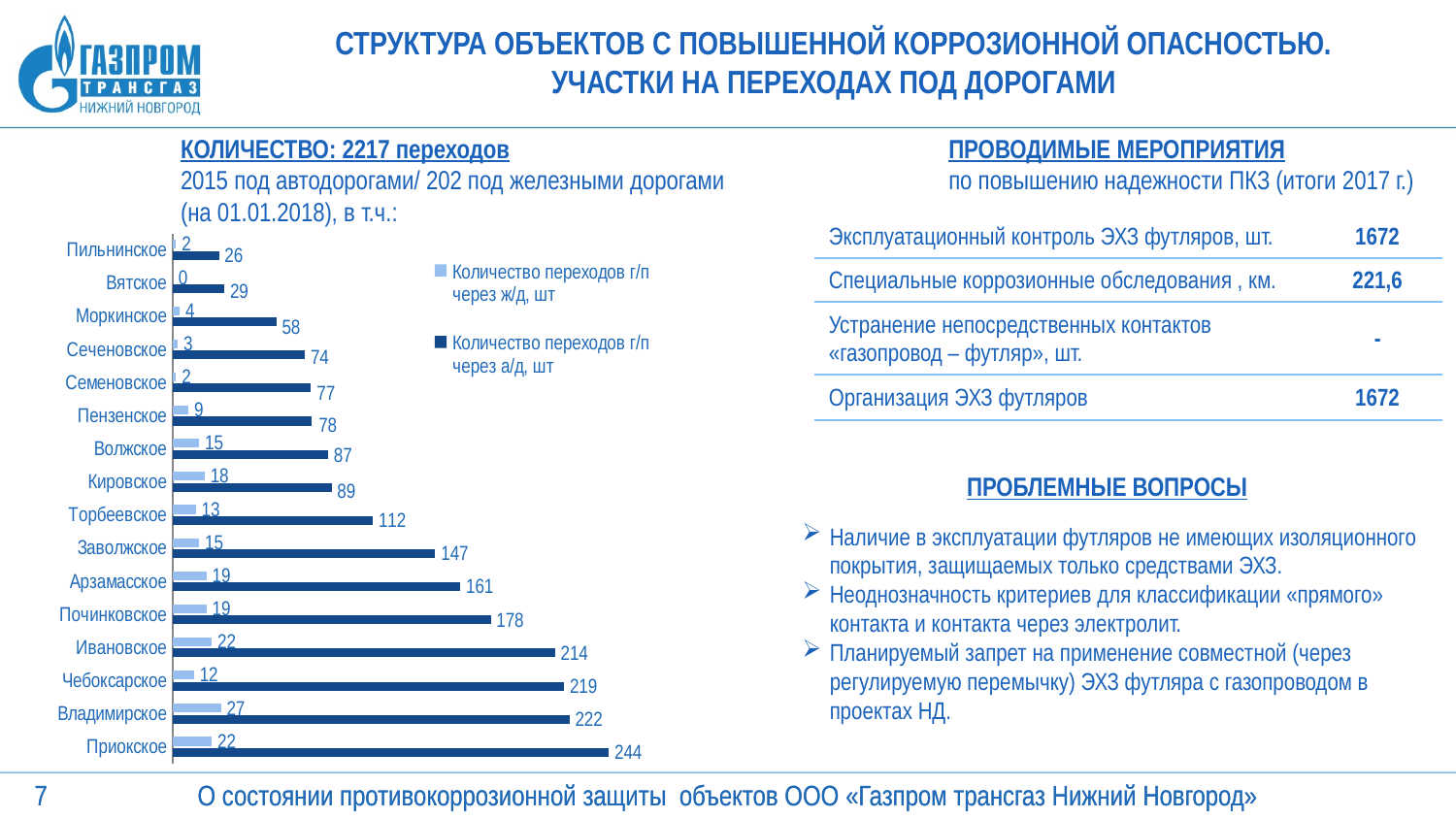
What is the total of the ж/д and а/д values for Ивановское? 236 What type of chart is shown on the slide? bar chart What is the value for Владимирское in the series 'Количество переходов г/п через ж/д, шт'? 27 What is the difference between the а/д values for Приокское and Владимирское? 22 What is the value for Торбеевское in the series 'Количество переходов г/п через а/д, шт'? 112 What is the value for Приокское in the series 'Количество переходов г/п через а/д, шт'? 244 Which category has the highest value in the series 'Количество переходов г/п через а/д, шт'? Приокское How many categories (branches) are shown on the chart? 16 Which colour represents the series 'Количество переходов г/п через а/д, шт' in the chart? dark blue Which is larger: the а/д value for Заволжское or for Арзамасское? Арзамасское Which category has the lowest value in the series 'Количество переходов г/п через ж/д, шт'? Вятское How many series does the chart legend list? 2